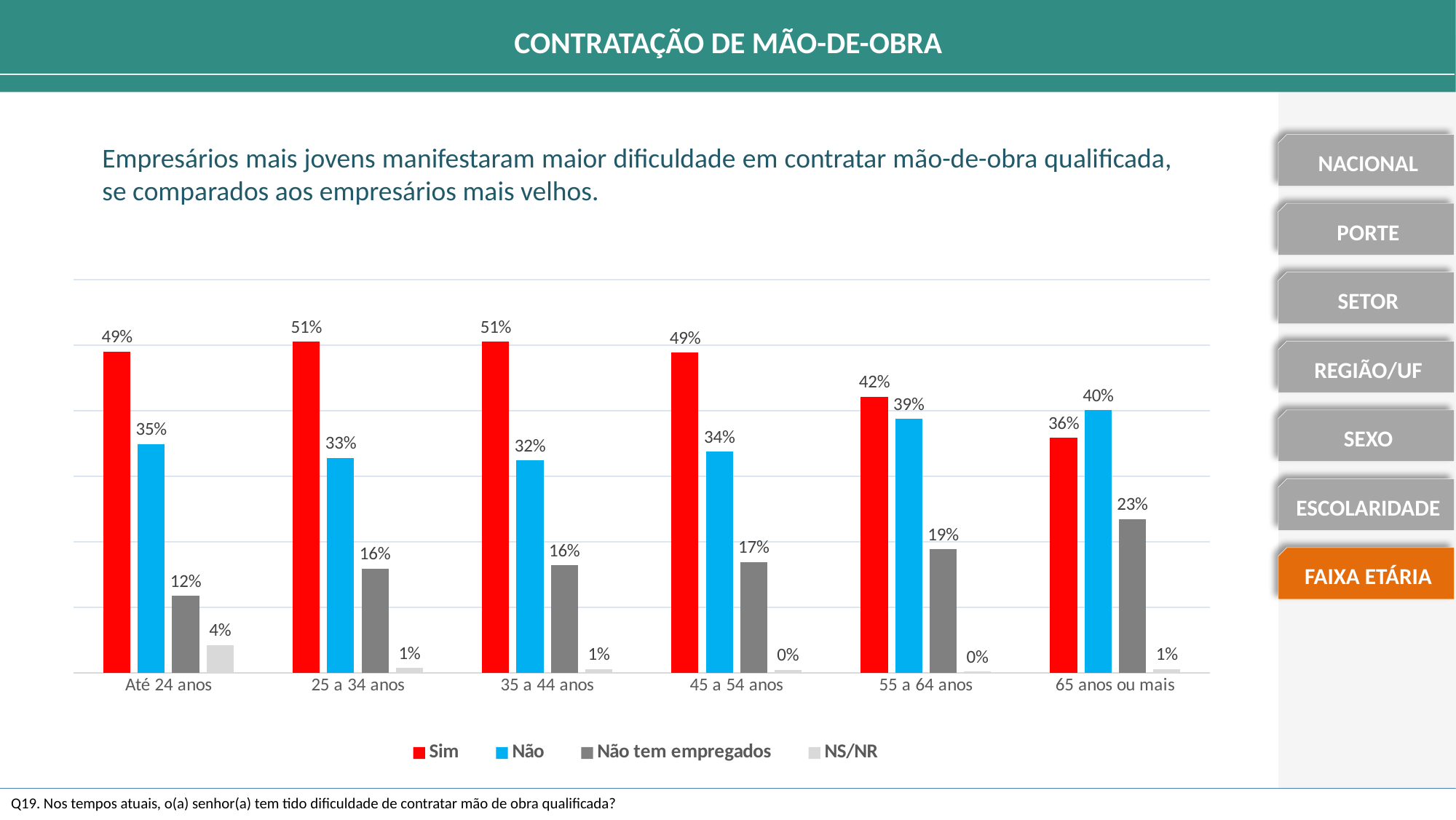
What kind of chart is shown on the slide? Bar chart What is the value of "Sim" for the "Até 24 anos" age group? 49% Which colour represents the "Sim" series in the chart? Red How many age groups are shown on the x axis? 6 Which age group has the highest value for "Não tem empregados"? 65 anos ou mais What is the value of "Não" for the "65 anos ou mais" age group? 40% How many series does the legend list? 4 What is the value of "Não tem empregados" for the "55 a 64 anos" age group? 19% Which age group has the lowest value for "Sim"? 65 anos ou mais What is the value of "NS/NR" for the "Até 24 anos" age group? 4% What is the difference between the "Sim" and "Não" values for the "45 a 54 anos" age group? 15% For the "65 anos ou mais" age group, which is larger: "Sim" or "Não"? Não